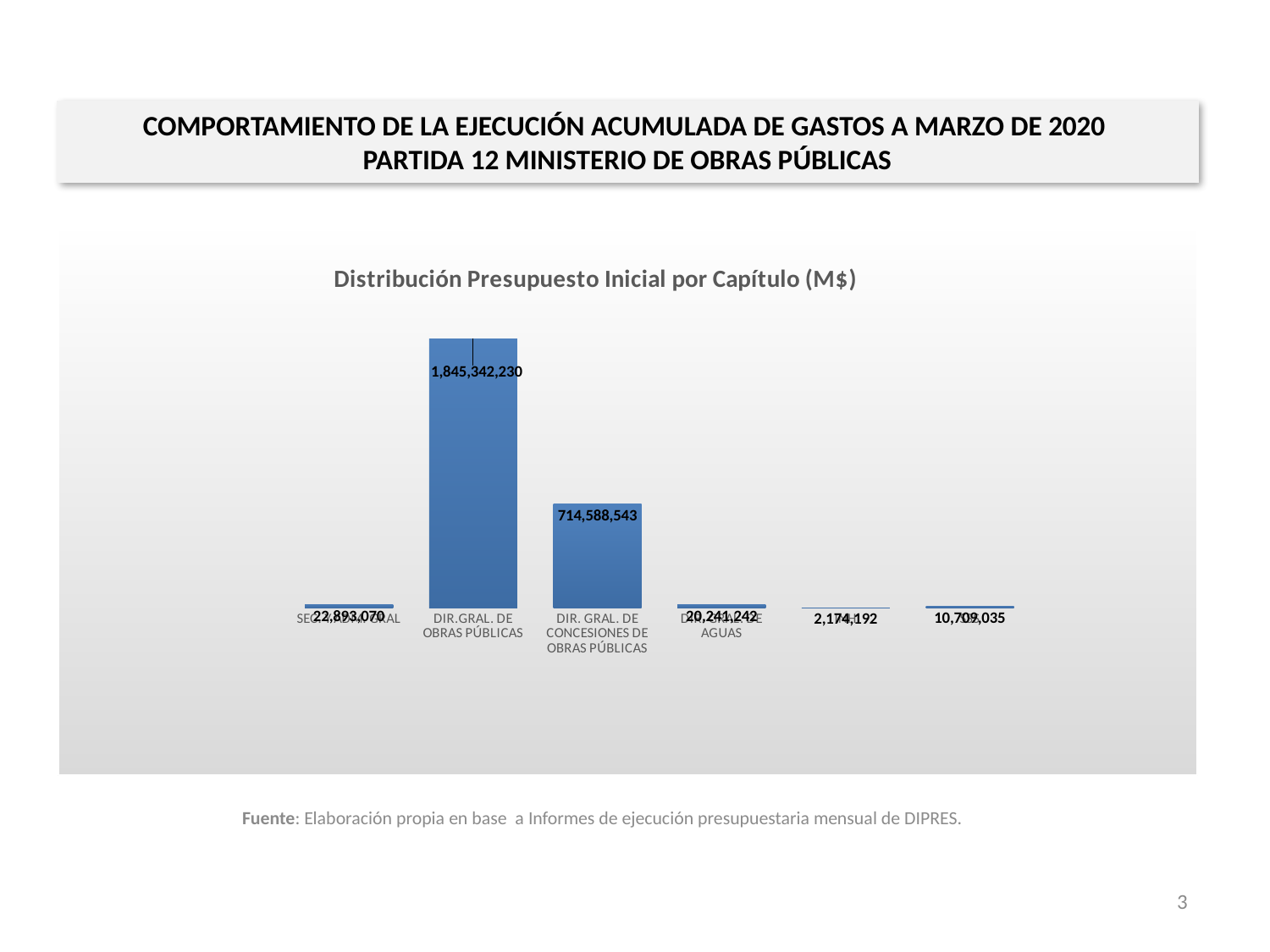
Which is larger, the value for DIR.GRAL. DE OBRAS PÚBLICAS or the value for DIR. GRAL. DE CONCESIONES DE OBRAS PÚBLICAS? DIR.GRAL. DE OBRAS PÚBLICAS What kind of chart is shown on the slide? bar chart What is the difference between the values for DIR.GRAL. DE OBRAS PÚBLICAS and DIR. GRAL. DE CONCESIONES DE OBRAS PÚBLICAS? 1,130,753,687 What is the value for DIR. GRAL. DE CONCESIONES DE OBRAS PÚBLICAS? 714,588,543 What is the title of the chart? Distribución Presupuesto Inicial por Capítulo (M$) How many bars does the chart show? 6 What is the largest value shown on the chart? 1,845,342,230 What is the value for DIR.GRAL. DE OBRAS PÚBLICAS? 1,845,342,230 Which category has the highest value? DIR.GRAL. DE OBRAS PÚBLICAS What is the smallest value shown on the chart? 2,174,192 In what unit are the values in the chart expressed, according to the chart title? M$